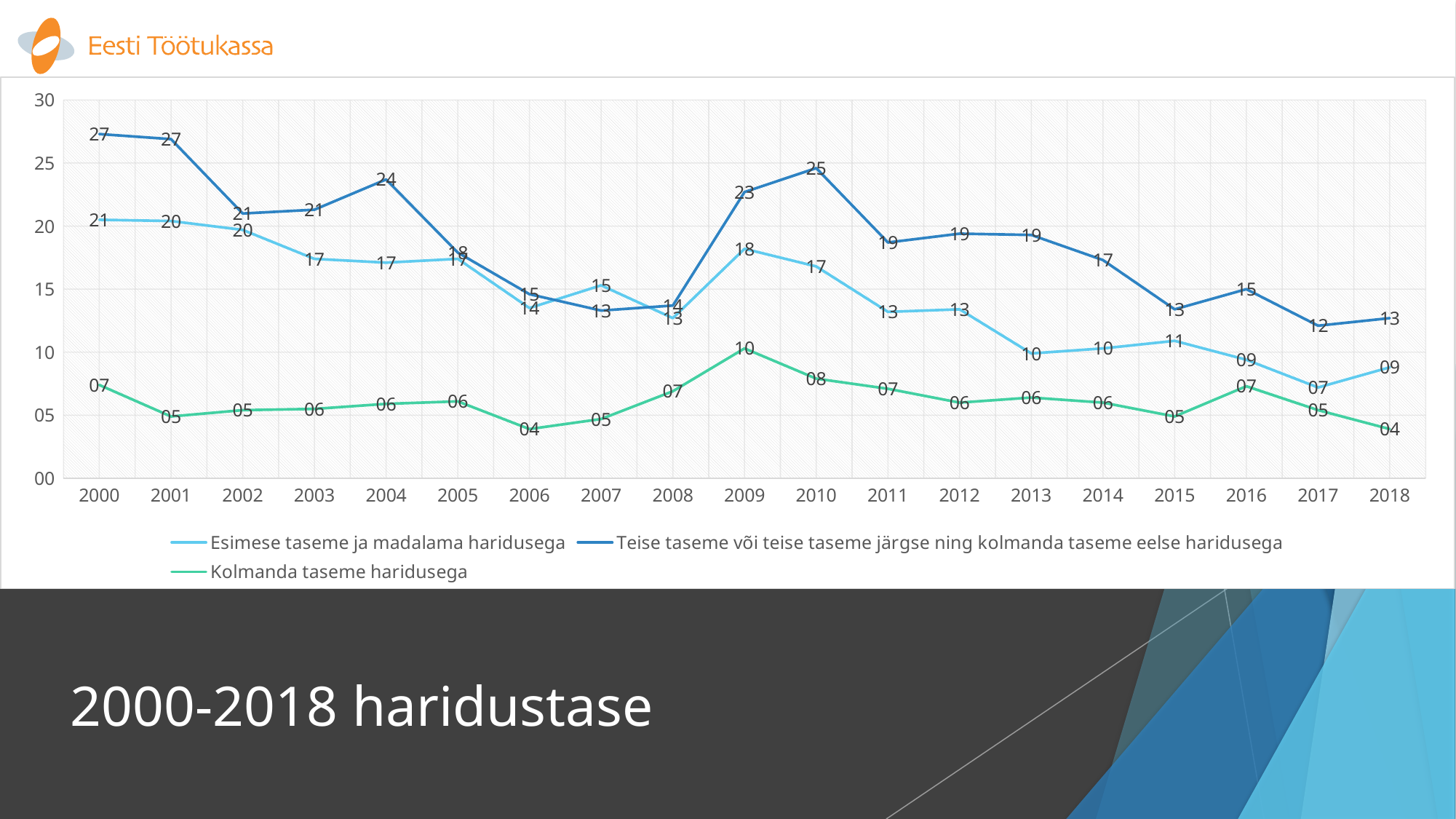
What is the difference between the Teise taseme või teise taseme järgse ning kolmanda taseme eelse haridusega value and the Esimese taseme ja madalama haridusega value in 2000? 6 How many series does the legend list? 3 Does the Esimese taseme ja madalama haridusega series generally rise or fall from 2000 to 2018? Fall What is the title of the slide? 2000-2018 haridustase In which year does the Kolmanda taseme haridusega series reach its highest value? 2009 What is the value for Teise taseme või teise taseme järgse ning kolmanda taseme eelse haridusega in 2010? 25 What kind of chart is shown on the slide? Line chart What is the value for Kolmanda taseme haridusega in 2009? 10 What is the value for Esimese taseme ja madalama haridusega in 2017? 07 In which year does the Teise taseme või teise taseme järgse ning kolmanda taseme eelse haridusega series reach its lowest value? 2017 Which series has the higher value in 2007: Esimese taseme ja madalama haridusega or Teise taseme või teise taseme järgse ning kolmanda taseme eelse haridusega? Esimese taseme ja madalama haridusega How many years are shown on the x axis? 19